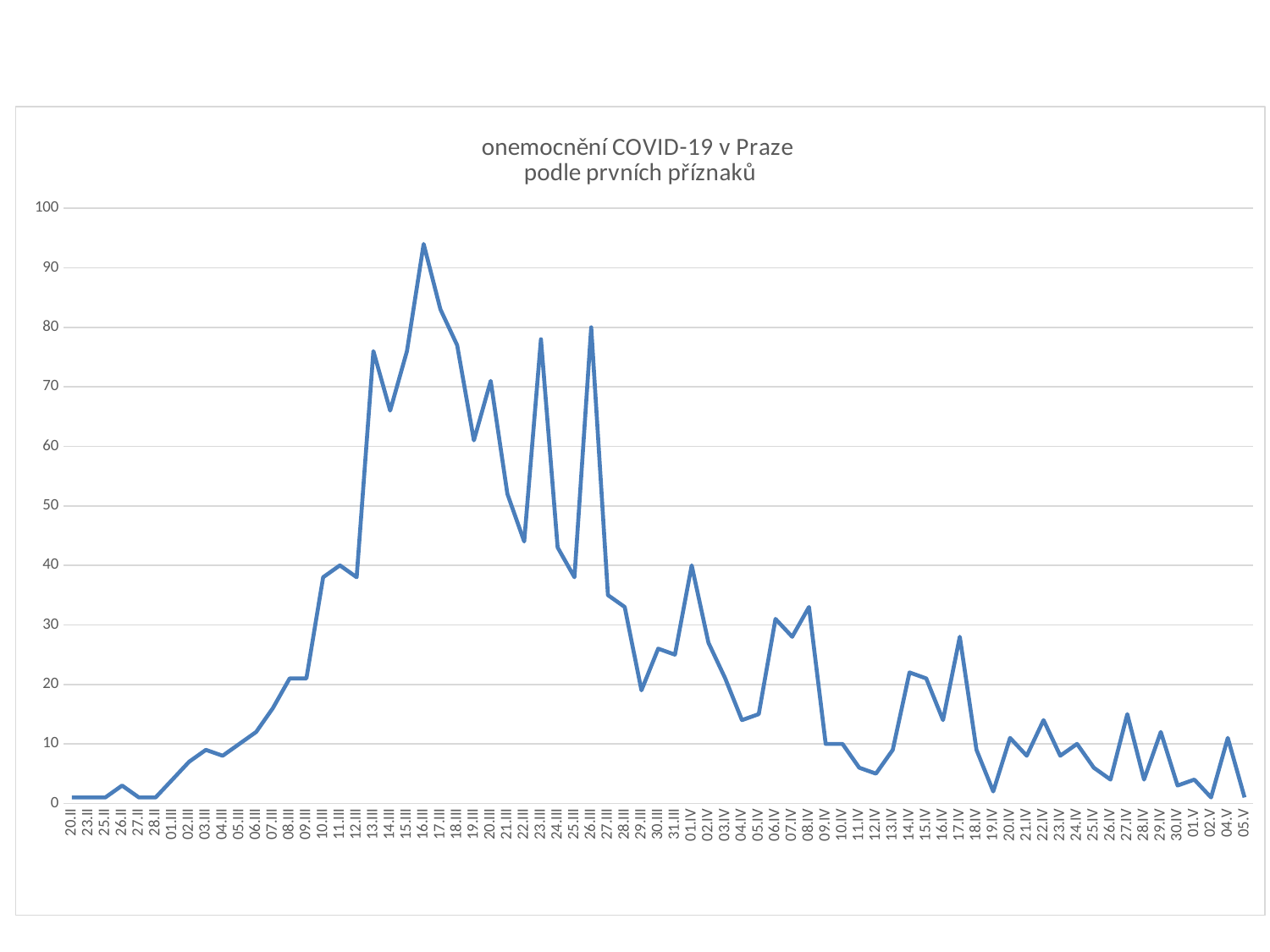
Is the value for 26.III greater or less than 70? greater What kind of chart is shown on the slide? line chart What is the title of the chart? onemocnění COVID-19 v Praze podle prvních příznaků On which date does the line reach its highest value? 16.III Is the value for 10.III greater or less than 30? greater Is the value for 19.IV greater or less than 10? less Which has the larger value, 16.III or 26.III? 16.III Do the values generally rise or fall from 16.III to 05.V? fall Which has the larger value, 01.IV or 02.IV? 01.IV